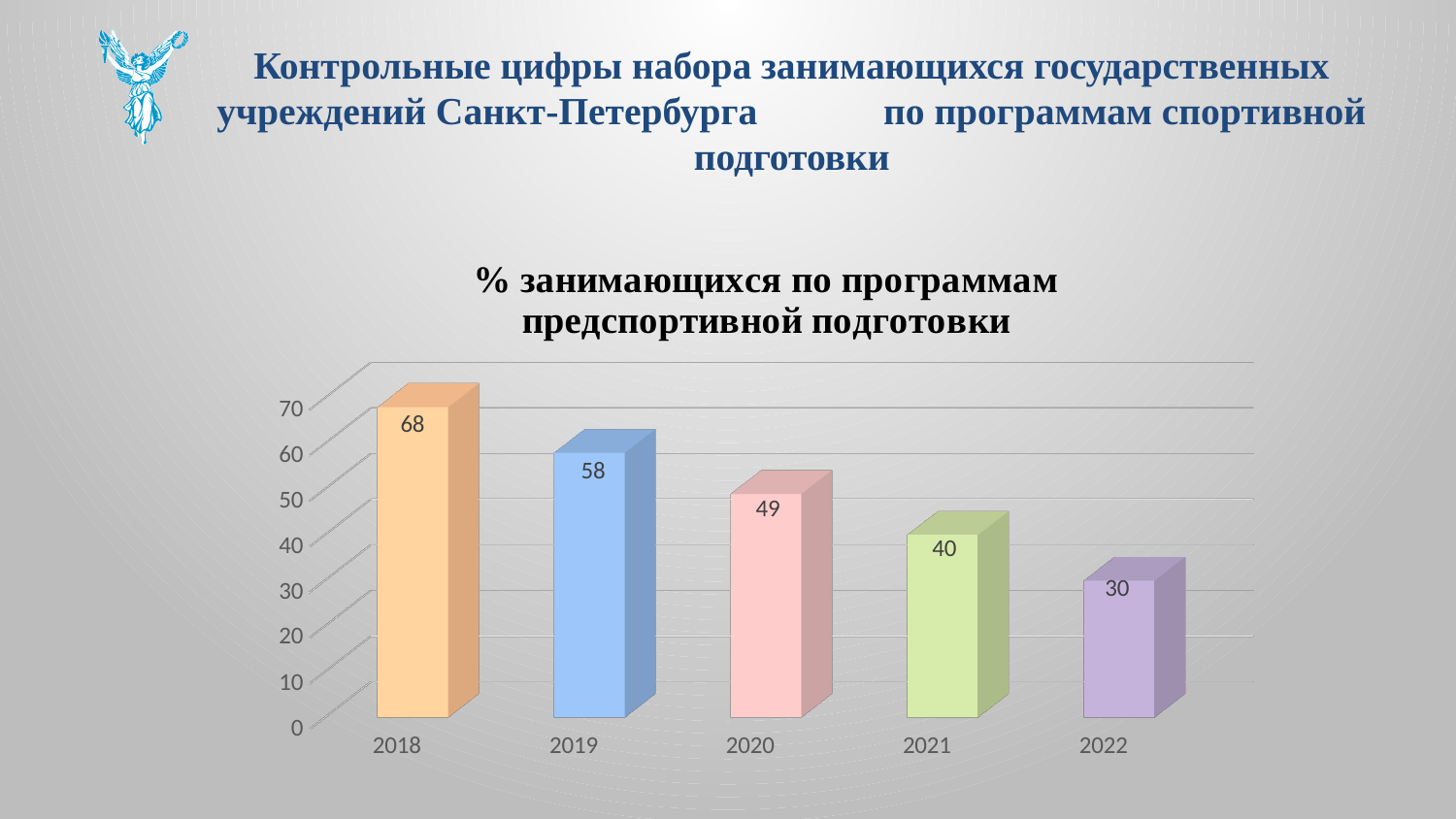
What kind of chart is shown on the slide? bar chart Which year has the highest value? 2018 What is the value for 2020? 49 What is the value for 2018? 68 Is the value for 2021 greater or less than 50? less How many years are shown on the x axis? 5 What is the value for 2022? 30 Do the values rise or fall from 2018 to 2022? fall Which is larger, the value for 2019 or the value for 2021? 2019 What is the difference between the values for 2018 and 2022? 38 Which year has the lowest value? 2022 What is the difference between the values for 2019 and 2020? 9